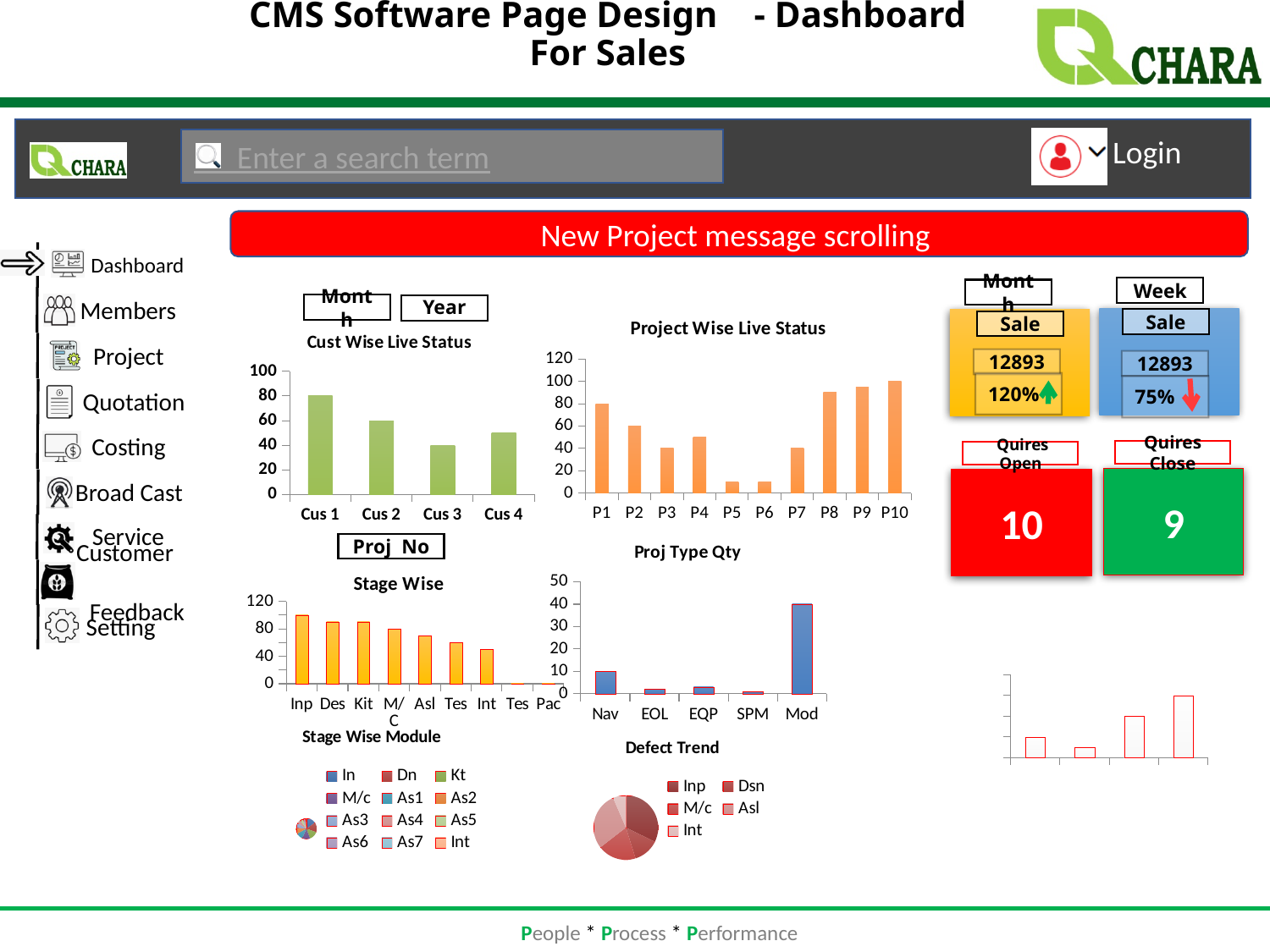
In the Cust Wise Live Status chart, is the value for Cus 4 greater or less than 40? greater In the Project Wise Live Status chart, what is the value for P10? 100 In the Cust Wise Live Status chart, which customer has the lowest value? Cus 3 In the Project Wise Live Status chart, is the value for P8 greater or less than 80? greater In the Proj Type Qty chart, what is the value for Mod? 40 In the Cust Wise Live Status chart, what is the difference between the values for Cus 1 and Cus 2? 20 In the Cust Wise Live Status chart, what is the value for Cus 1? 80 In the Stage Wise chart, which category has the highest value? Inp What kind of chart is the Stage Wise Module chart? Pie chart In the Project Wise Live Status chart, which is larger, the value for P1 or the value for P5? P1 In the Project Wise Live Status chart, how many projects are shown on the x axis? 10 How many entries does the legend of the Defect Trend chart list? 5